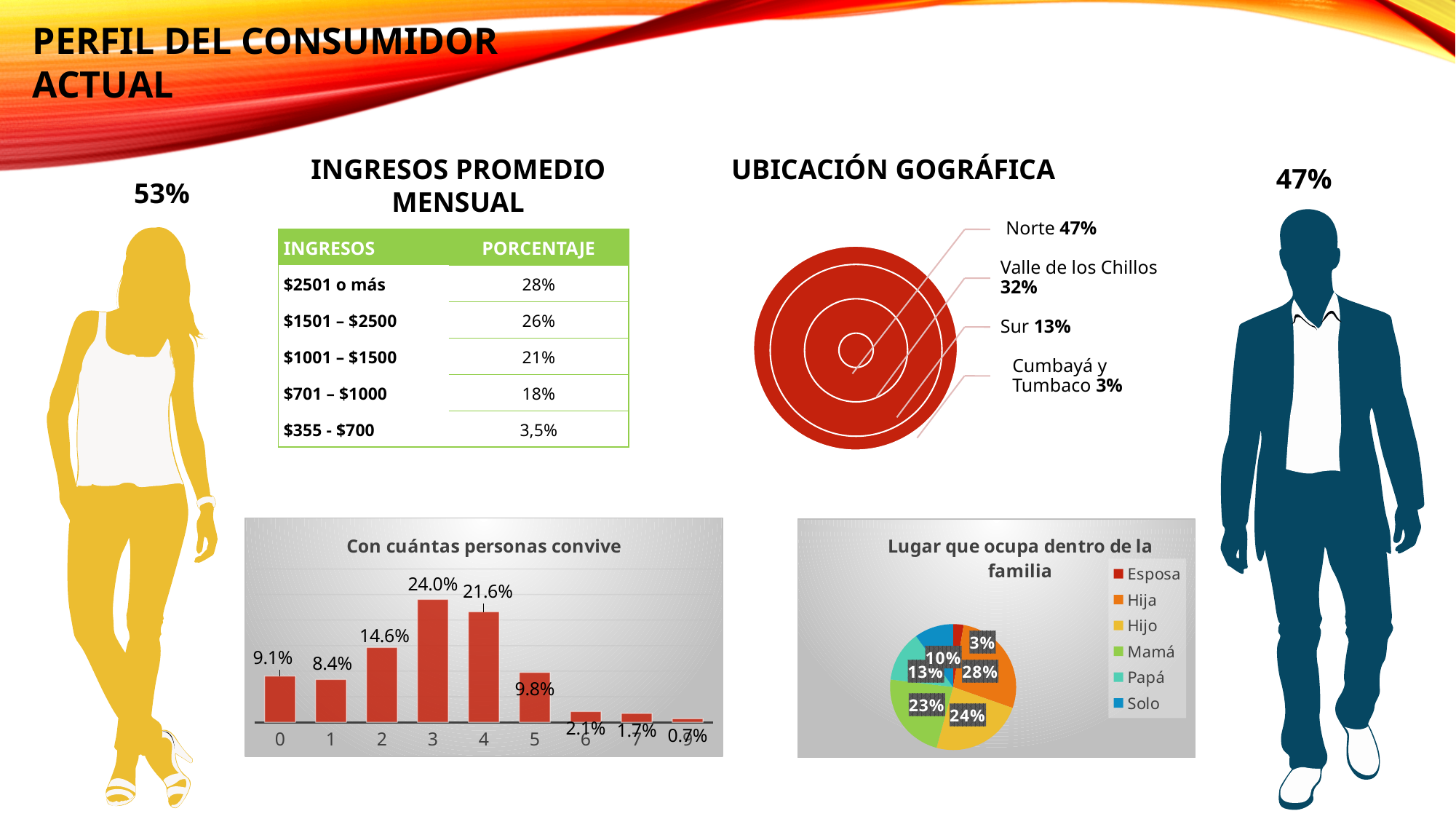
In the 'Con cuántas personas convive' chart, what is the difference between the values for categories 3 and 4? 2.4% In the 'Lugar que ocupa dentro de la familia' pie chart, which is larger, Mamá or Papá? Mamá In the 'Con cuántas personas convive' chart, which is larger, the value for category 0 or category 1? 0 In the 'Lugar que ocupa dentro de la familia' pie chart, what share does Esposa have? 3% In the 'Lugar que ocupa dentro de la familia' pie chart, what share does Hija have? 28% In the 'Con cuántas personas convive' chart, what is the value for category 5? 9.8% What kind of chart is 'Con cuántas personas convive'? Bar chart How many entries does the legend of the 'Lugar que ocupa dentro de la familia' chart list? 6 In the 'Con cuántas personas convive' chart, which category has the lowest value? 9 In the 'Con cuántas personas convive' chart, which category has the highest value? 3 In the 'Con cuántas personas convive' chart, what is the value for category 3? 24.0% How many categories are shown on the x axis of the 'Con cuántas personas convive' chart? 9